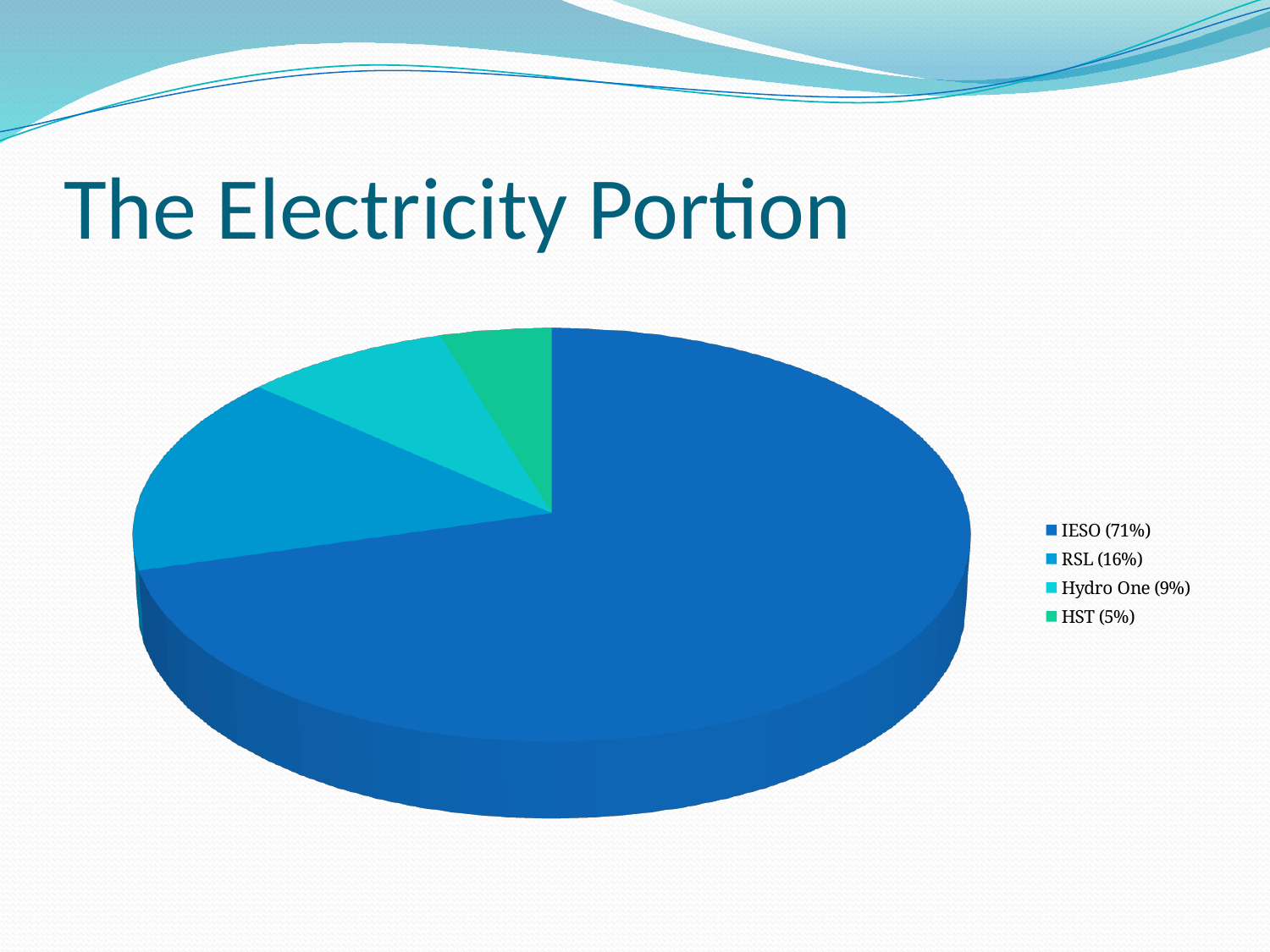
What is the title of the slide containing the pie chart? The Electricity Portion Which category has the smallest slice of the pie? HST Which is larger, the share for RSL or the share for Hydro One? RSL What is the difference in percentage points between the IESO and RSL shares? 55 What kind of chart is shown on the slide? pie chart What share of the pie does Hydro One represent? 9% How many entries are listed in the legend? 4 How many slices does the pie chart have? 4 What share of the pie does IESO represent? 71% What share of the pie does HST represent? 5% Which category has the largest slice of the pie? IESO